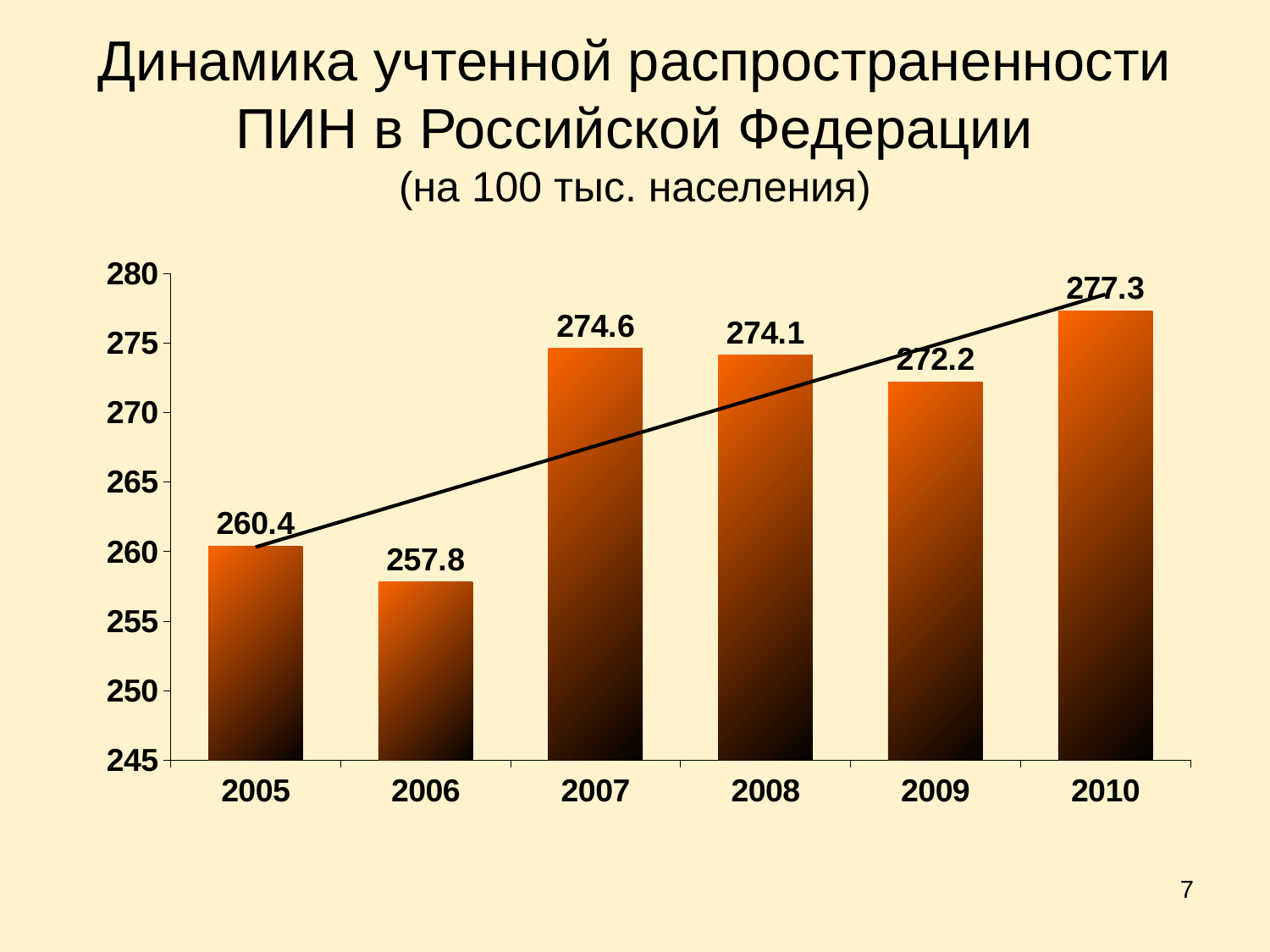
What kind of chart is shown on the slide? bar chart Is the value for 2006 greater or less than 260? less What is the value for 2010? 277.3 Does the trend line drawn across the chart rise or fall from 2005 to 2010? rise Which year has the highest value? 2010 Which is larger, the value for 2009 or the value for 2008? 2008 What is the value for 2008? 274.1 What is the value for 2005? 260.4 What is the difference between the values for 2010 and 2005? 16.9 What is the difference between the values for 2007 and 2006? 16.8 How many years are shown on the x axis? 6 Which year has the lowest value? 2006